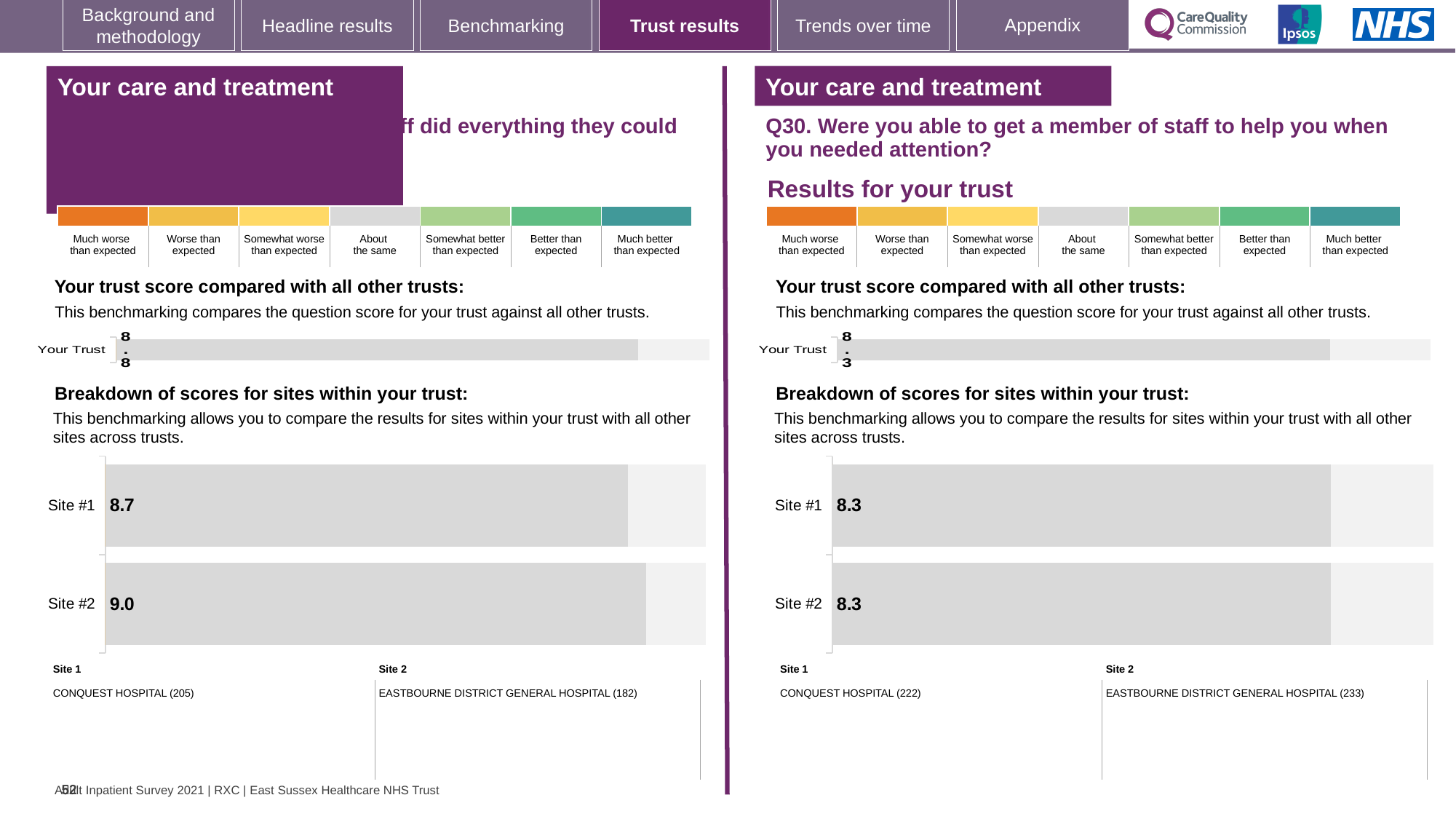
On the Q30 'Your trust score compared with all other trusts' chart, what is the score for Your Trust? 8.3 On the left-hand 'Your trust score compared with all other trusts' chart, what is the score for Your Trust? 8.8 On the left-hand 'Breakdown of scores for sites within your trust' chart, what is the score for Site #1? 8.7 On the left-hand 'Breakdown of scores for sites within your trust' chart, what is the difference between the Site #2 and Site #1 scores? 0.3 On the Q30 'Breakdown of scores for sites within your trust' chart, what is the score for Site #1? 8.3 On the left-hand 'Breakdown of scores for sites within your trust' chart, is the Site #2 score larger or smaller than the Site #1 score? Larger On the Q30 'Breakdown of scores for sites within your trust' chart, how many sites are shown? 2 On the Q30 'Breakdown of scores for sites within your trust' chart, what is the score for Site #2? 8.3 On the left-hand 'Breakdown of scores for sites within your trust' chart, which site has the higher score? Site #2 On the left-hand 'Breakdown of scores for sites within your trust' chart, what is the score for Site #2? 9.0 What type of chart is used for the Q30 'Breakdown of scores for sites within your trust'? Bar chart On the Q30 side of the slide, which hospital is listed as Site 2? EASTBOURNE DISTRICT GENERAL HOSPITAL (233)